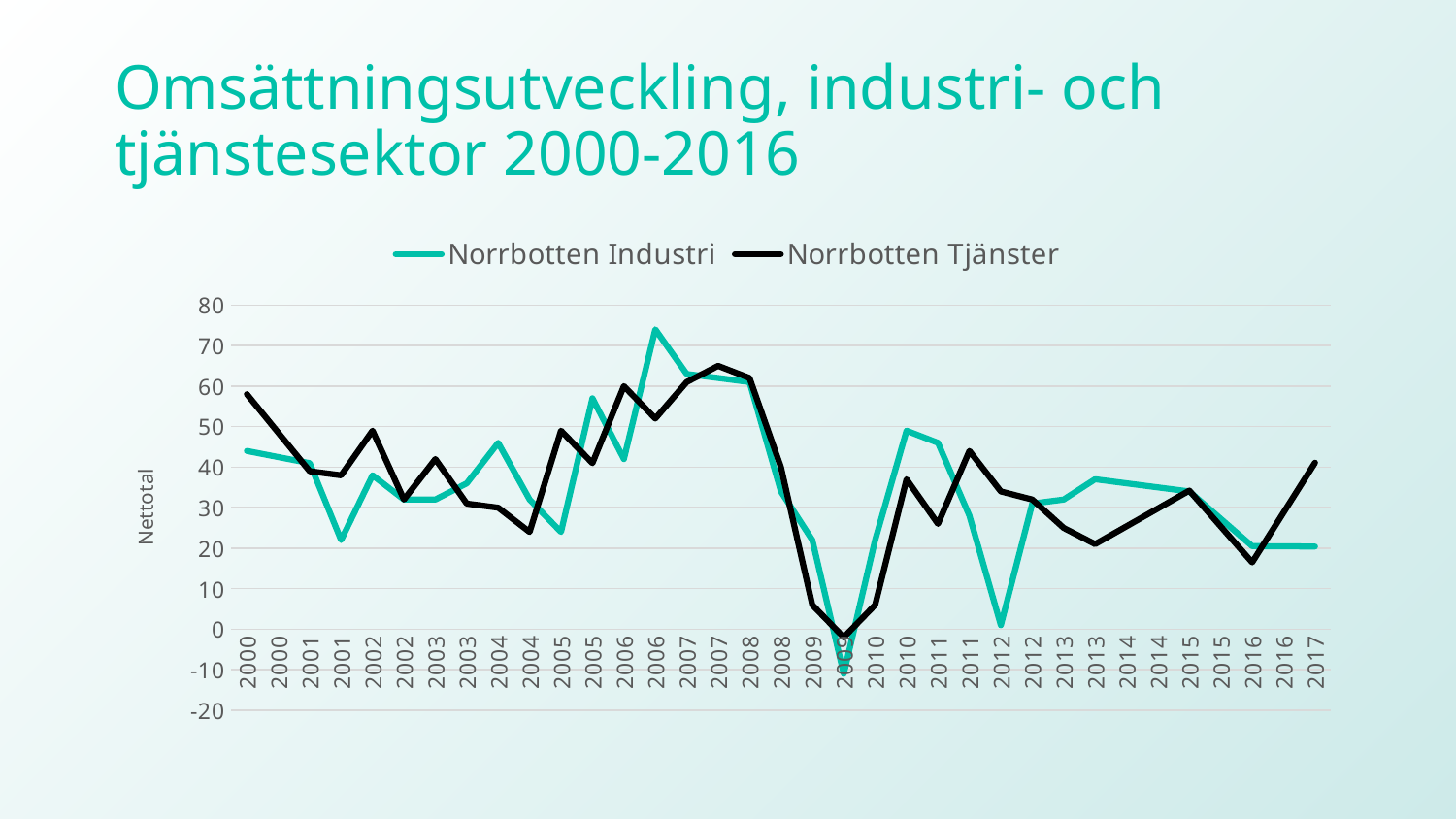
Is the value for Norrbotten Tjänster at the first 2000 point greater or less than 50? greater Is the peak value for Norrbotten Industri in 2006 greater or less than 70? greater Is the value for Norrbotten Industri at 2017 greater or less than 30? less Which series is drawn in black? Norrbotten Tjänster At 2017, which series has the higher value, Norrbotten Industri or Norrbotten Tjänster? Norrbotten Tjänster At the first 2000 point, which series has the higher value, Norrbotten Industri or Norrbotten Tjänster? Norrbotten Tjänster In which year does Norrbotten Tjänster reach its lowest value? 2009 In which year does Norrbotten Industri reach its highest value? 2006 How many series does the legend list? 2 What is the label on the vertical axis? Nettotal What kind of chart is shown on the slide? Line chart